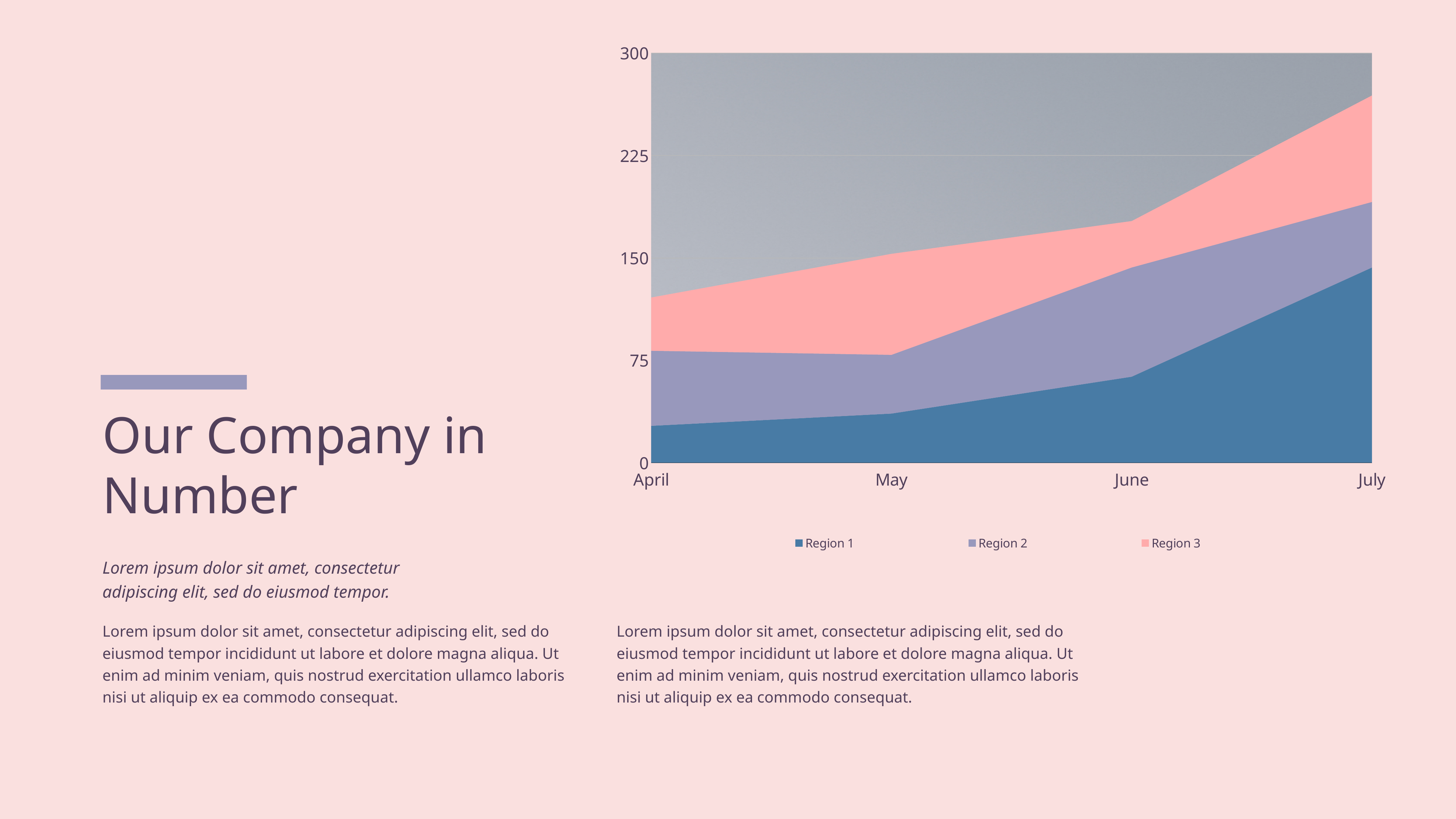
Is the value for Region 1 in June greater or less than 75? less Is the value for Region 1 larger in April or in July? July How many months are shown along the x axis of the chart? 4 Which series are listed in the chart's legend? Region 1, Region 2, Region 3 Is the value for Region 1 in April greater or less than 75? less Which month has the highest value for Region 1? July Is the stacked total of all three regions in July greater or less than 225? greater How many series does the chart's legend list? 3 Which month has the lowest value for Region 1? April What kind of chart is shown on the slide? Area chart Does the value for Region 1 rise or fall from April to July? Rise